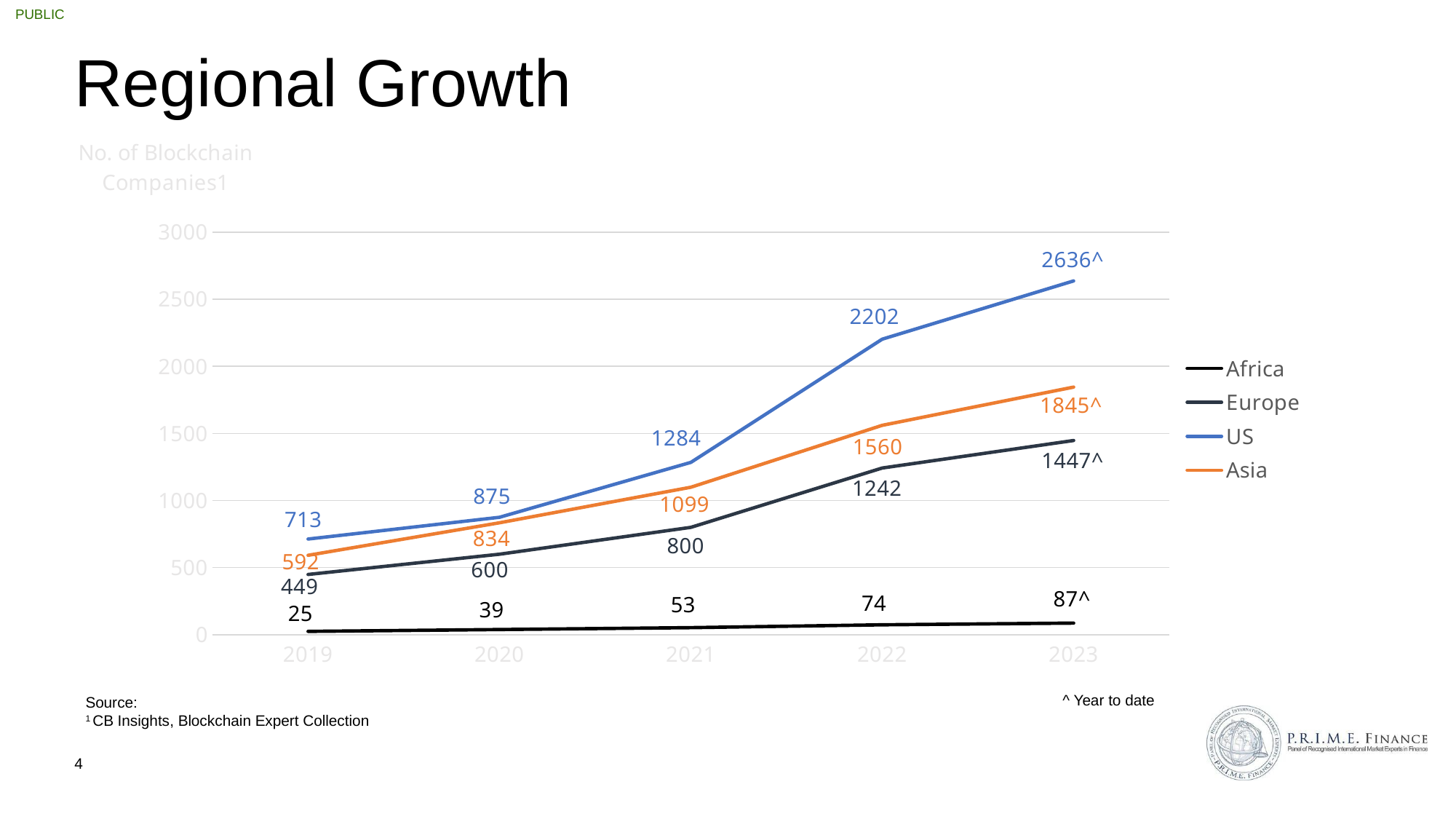
What is the value for Africa in 2023? 87^ What is the value for Asia in 2020? 834 What kind of chart is shown on the slide? Line chart Which region has the lowest value in 2019? Africa What is the value for US in 2021? 1284 Do the values for Europe rise or fall from 2019 to 2023? Rise Which region has the highest value in 2023? US Which is larger in 2020: the value for Europe or the value for Asia? Asia What is the difference between the US and Asia values in 2022? 642 How many series does the legend list? 4 What is the value for Europe in 2022? 1242 How many years are shown on the x axis? 5